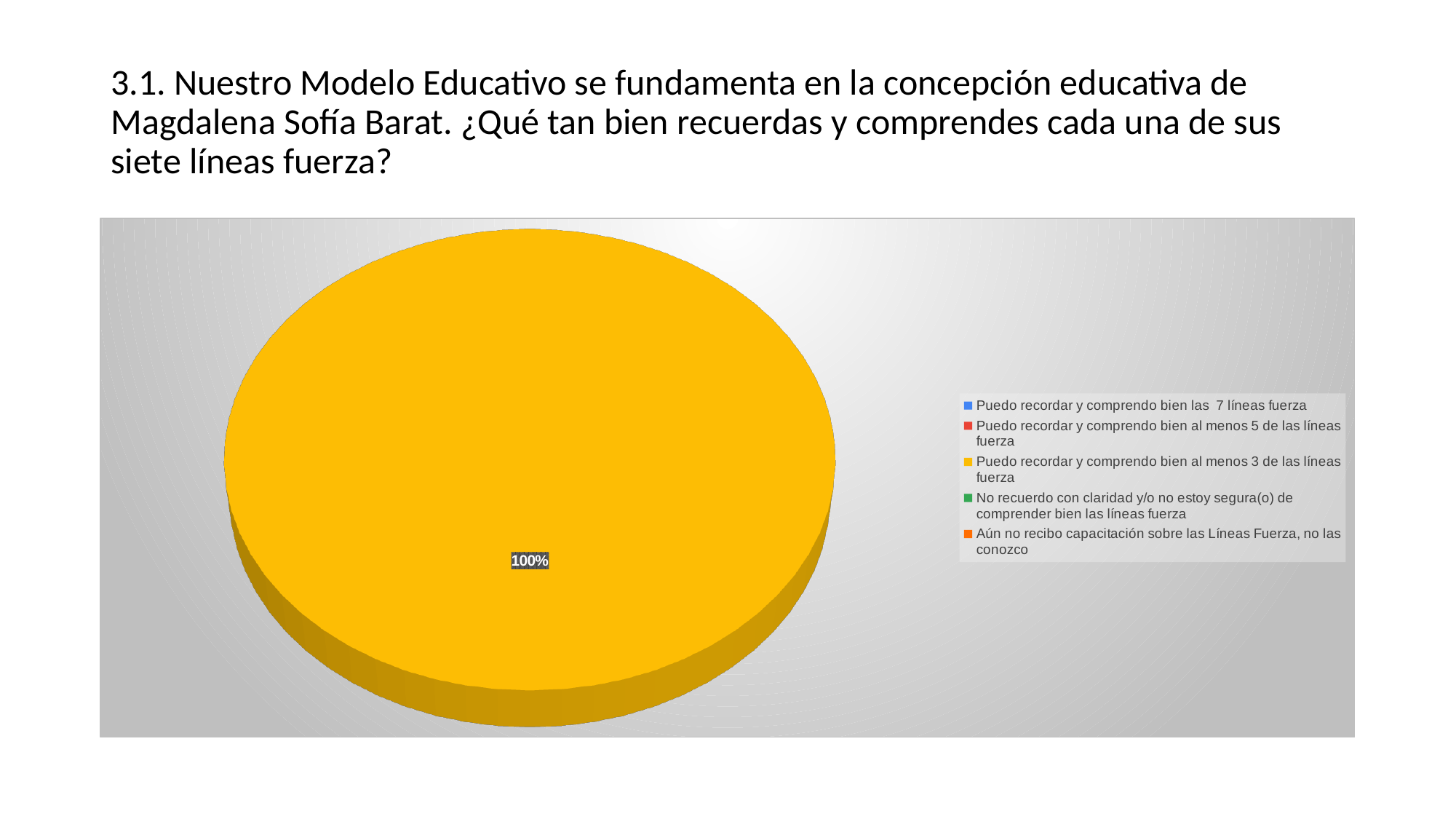
Which legend entry is shown with a blue marker? Puedo recordar y comprendo bien las 7 líneas fuerza What is the value shown for 'Puedo recordar y comprendo bien al menos 3 de las líneas fuerza'? 100% Which category has the largest share of the pie? Puedo recordar y comprendo bien al menos 3 de las líneas fuerza What share of the pie does the yellow slice represent? 100% How many entries does the legend list? 5 How many slices are visible in the pie? 1 Which legend category does the slice labelled 100% correspond to? Puedo recordar y comprendo bien al menos 3 de las líneas fuerza Is the share for 'Puedo recordar y comprendo bien al menos 3 de las líneas fuerza' greater or less than 50%? greater What kind of chart is shown on the slide? Pie chart What colour is the slice labelled 100%? Yellow